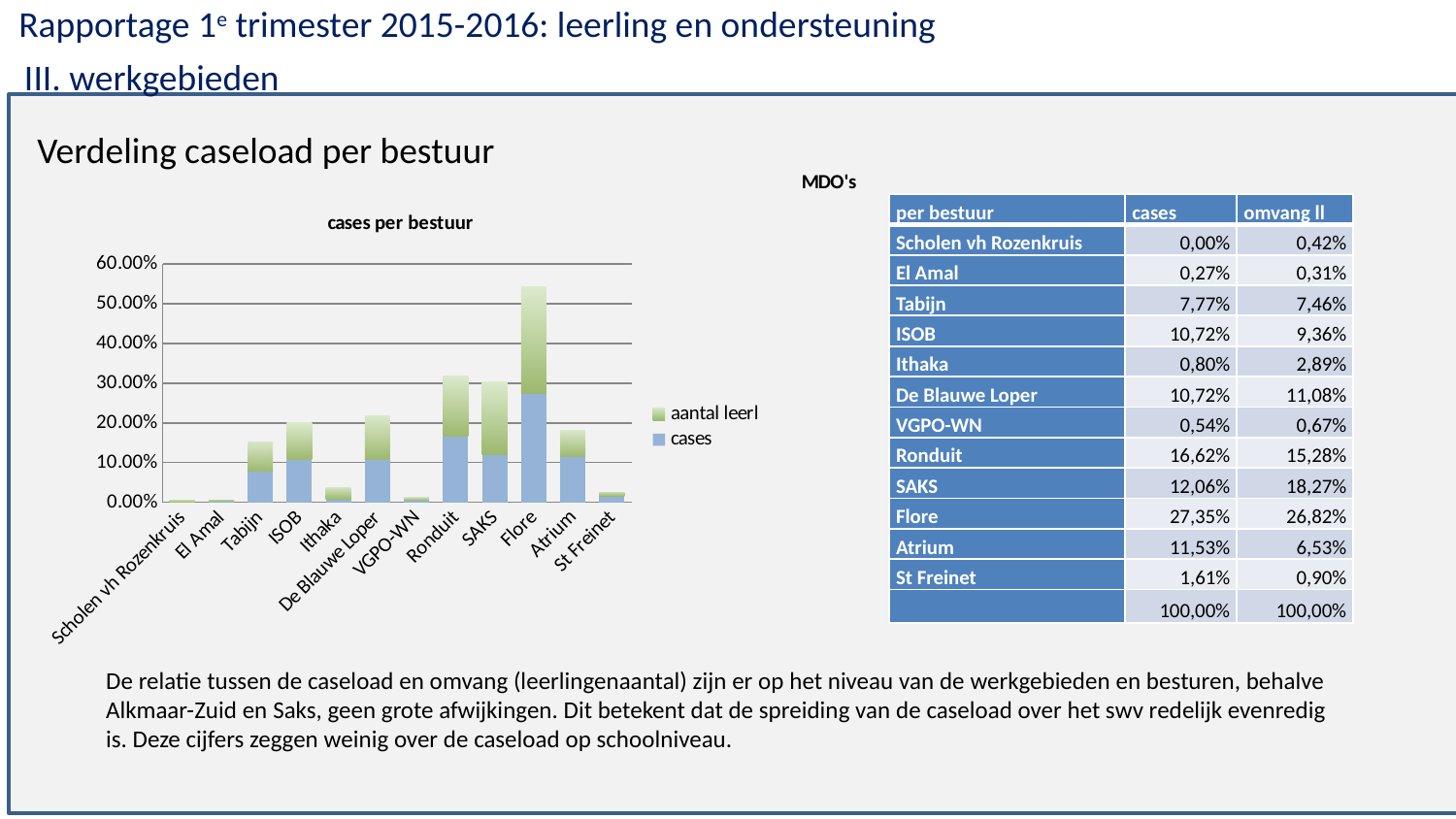
Is the total stacked value for Flore greater or less than 50.00%? greater What is the title of the chart on the slide? cases per bestuur How many categories (besturen) are shown on the x axis of the chart? 12 Which has the larger stacked bar, Flore or Ronduit? Flore Is the total stacked value for Ithaka greater or less than 10.00%? less Which has the larger stacked bar, Tabijn or Ithaka? Tabijn What type of chart is shown on the slide? stacked bar chart Is the total stacked value for Ronduit greater or less than 30.00%? greater How many series does the chart's legend list? 2 Which bestuur has the highest stacked bar in the chart? Flore Which series are listed in the chart's legend? aantal leerl, cases